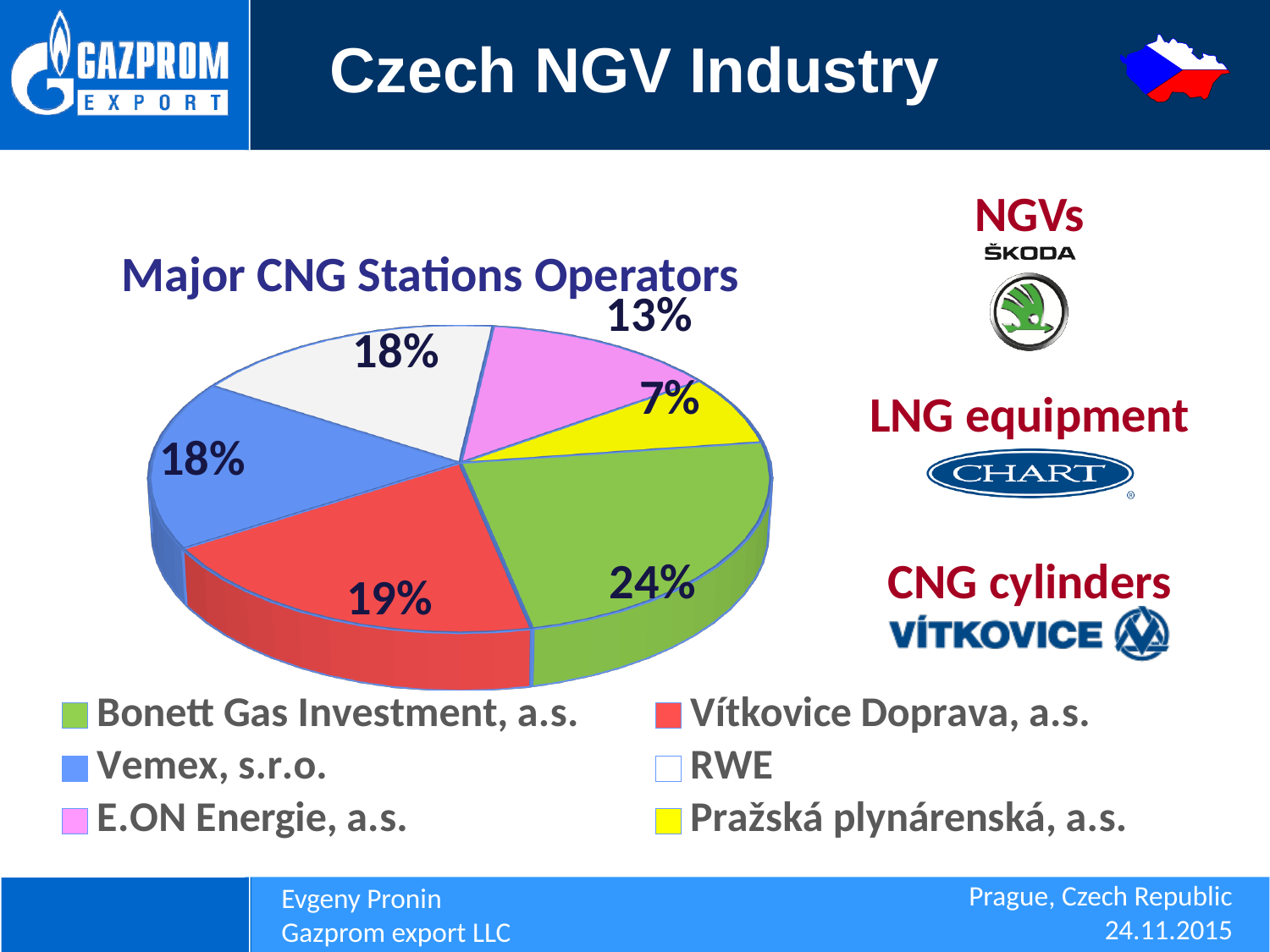
Which has a larger share, E.ON Energie, a.s. or Vemex, s.r.o.? Vemex, s.r.o. Which operator has the smallest slice of the pie? Pražská plynárenská, a.s. What is the title of the pie chart? Major CNG Stations Operators What share of the pie does Vítkovice Doprava, a.s. hold? 19% What share of the pie does E.ON Energie, a.s. hold? 13% What share of the pie does Pražská plynárenská, a.s. hold? 7% Which operator has the largest slice of the pie? Bonett Gas Investment, a.s. What kind of chart is shown under the title "Major CNG Stations Operators"? Pie chart Which colour represents RWE in the pie chart? White What is the difference in percentage points between Bonett Gas Investment, a.s. and Vítkovice Doprava, a.s.? 5 What share of the pie does Bonett Gas Investment, a.s. hold? 24% How many operators are shown in the pie chart? 6